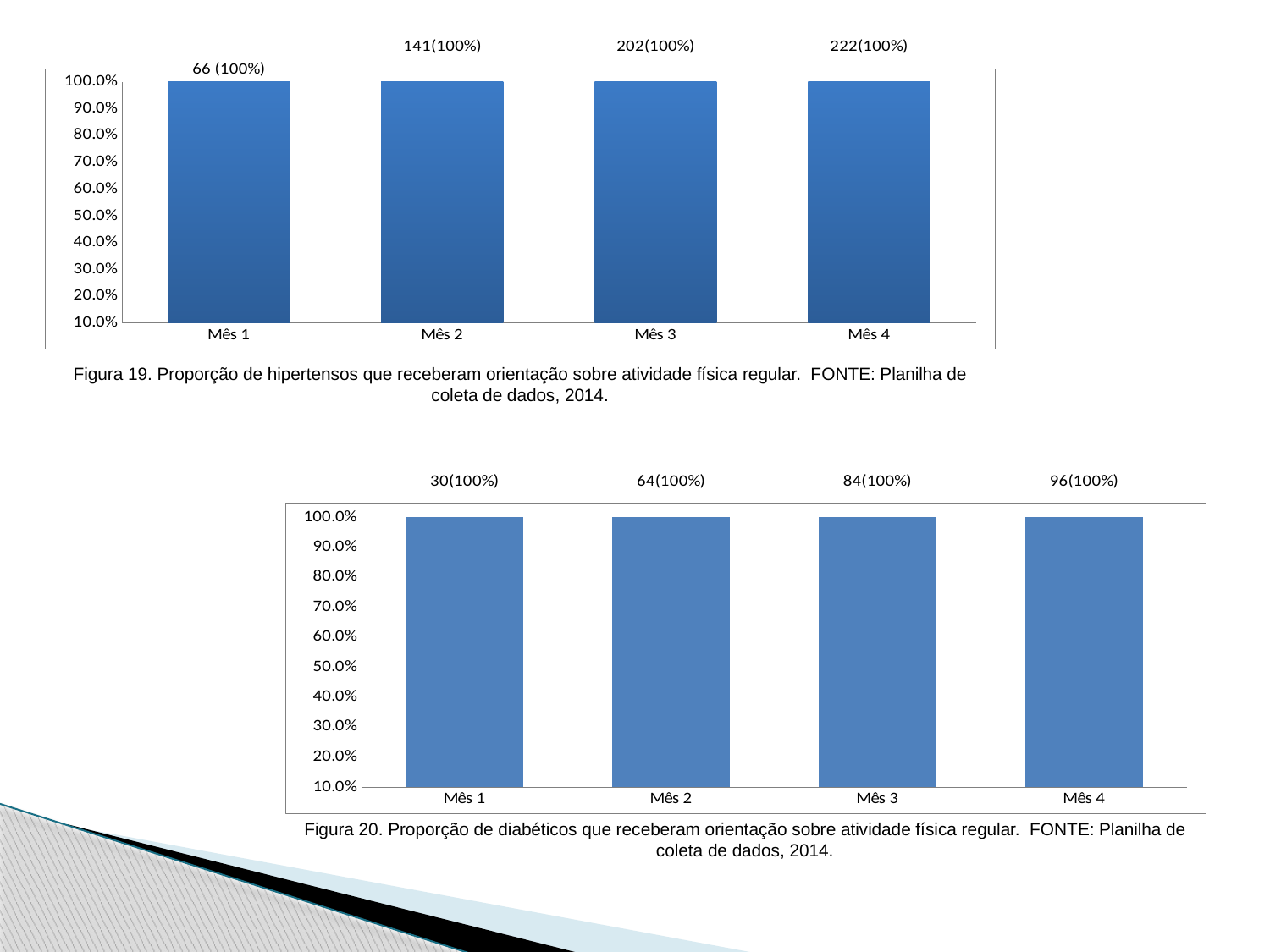
In the bottom chart (Figura 20), what is the data label shown above the bar for Mês 4? 96(100%) What kind of chart is the bottom chart (Figura 20)? Bar chart In the top chart (Figura 19), do the percentage values rise, fall, or stay the same from Mês 1 to Mês 4? Stay the same In the top chart (Figura 19), what is the data label shown above the bar for Mês 3? 202(100%) How many categories (months) are shown on the x axis of the top chart (Figura 19)? 4 In the top chart (Figura 19), what is the data label shown above the bar for Mês 4? 222(100%) In the top chart (Figura 19), what is the data label shown above the bar for Mês 1? 66 (100%) In the bottom chart (Figura 20), what is the data label shown above the bar for Mês 1? 30(100%) In the top chart (Figura 19), what is the difference between the count labelled for Mês 4 (222) and the count labelled for Mês 1 (66)? 156 In the bottom chart (Figura 20), what is the difference between the count labelled for Mês 3 (84) and the count labelled for Mês 2 (64)? 20 In the bottom chart (Figura 20), what is the data label shown above the bar for Mês 2? 64(100%) What is the highest value shown on the y axis of the bottom chart (Figura 20)? 100.0%